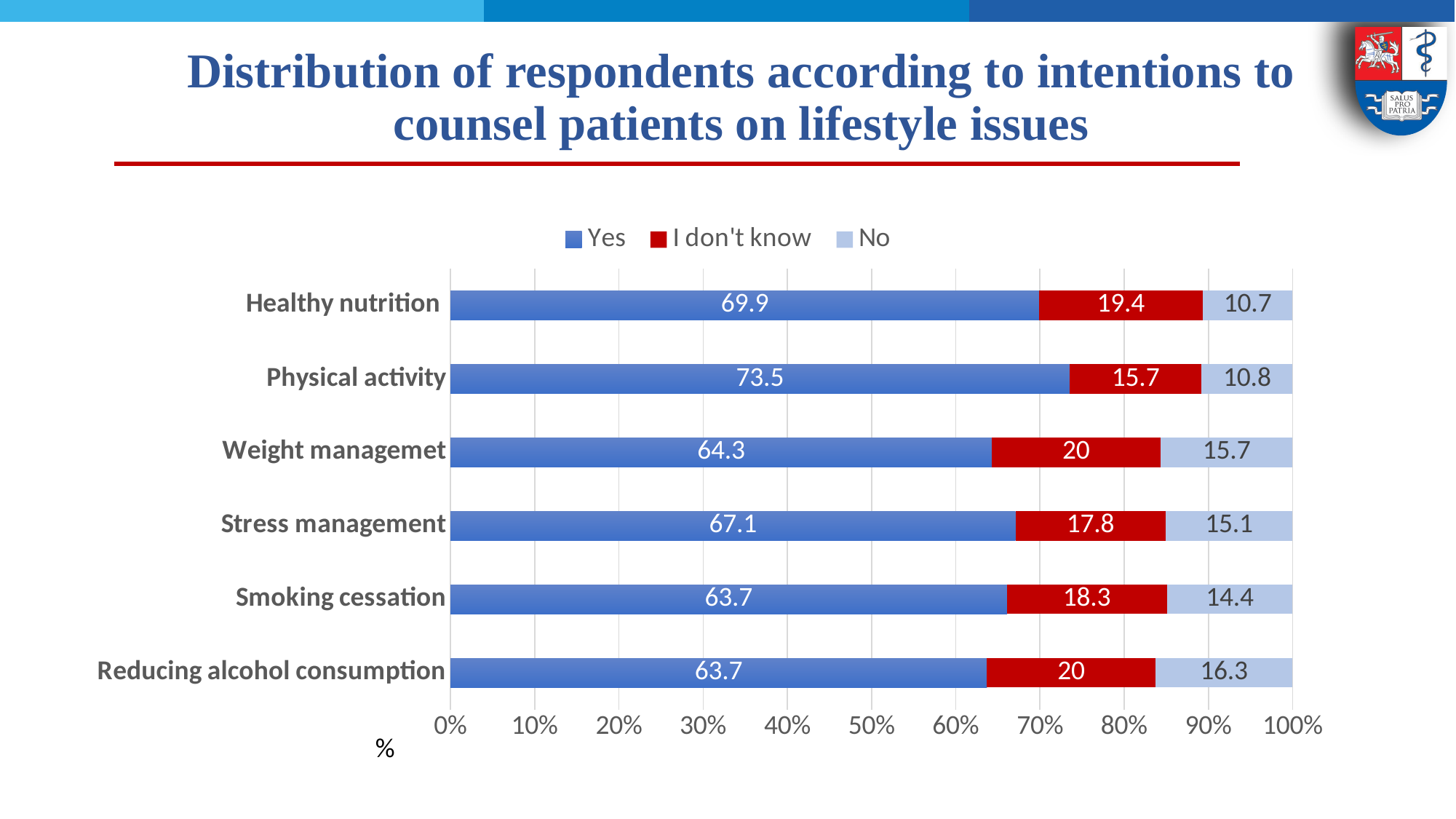
What is the 'I don't know' value for Healthy nutrition? 19.4 What kind of chart is shown on the slide? Stacked bar chart What colour represents the 'I don't know' series? Red What is the difference between the 'Yes' values for Physical activity and Weight managemet? 9.2 What is the 'Yes' value for Physical activity? 73.5 What is the total of the stacked bar for Healthy nutrition? 100 How many series does the legend list? 3 Which category has the lowest 'No' value? Healthy nutrition What is the 'No' value for Reducing alcohol consumption? 16.3 Which is larger, the 'I don't know' value for Stress management or for Smoking cessation? Smoking cessation Which category has the highest 'Yes' value? Physical activity How many categories are shown on the chart? 6